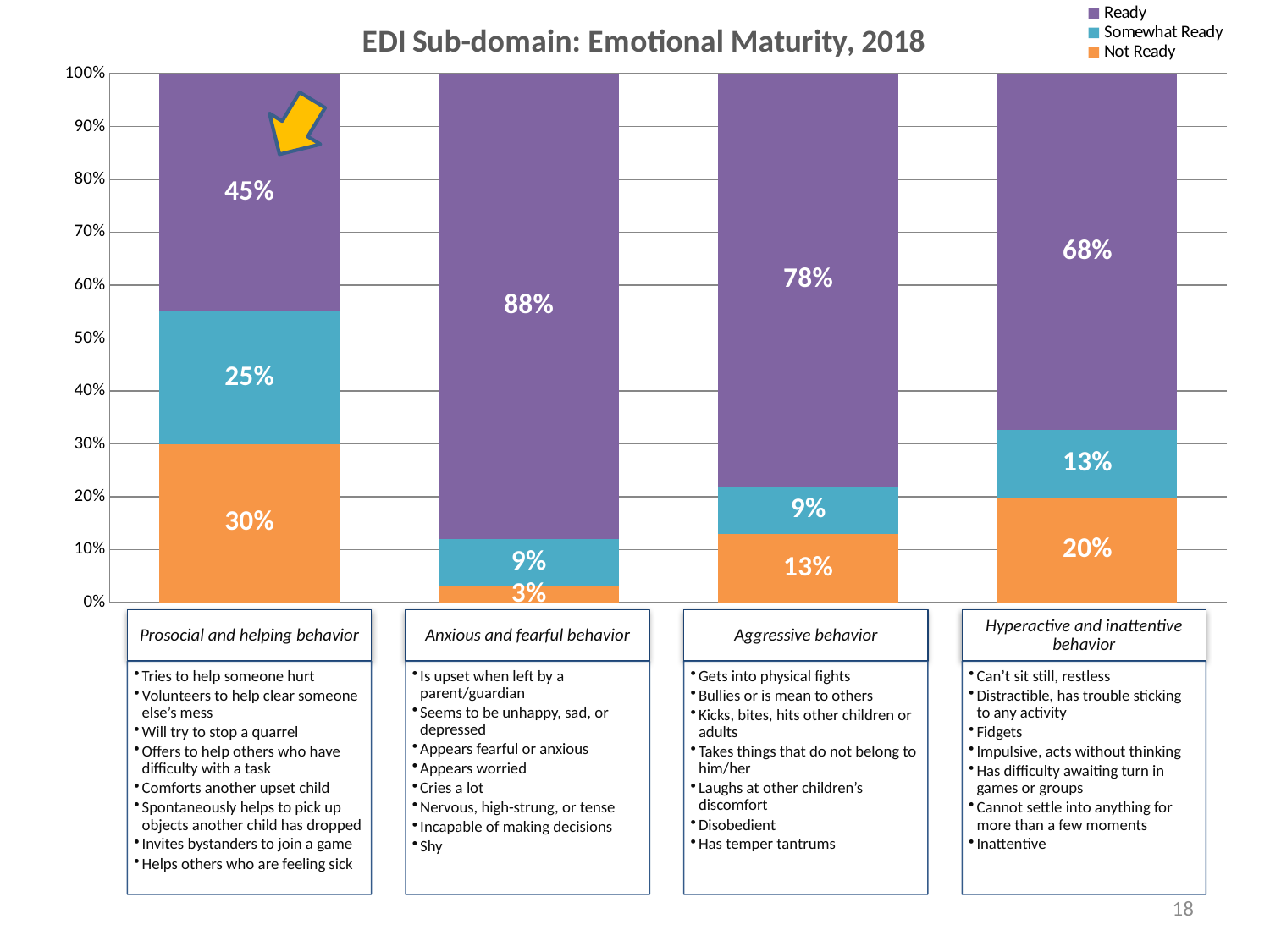
Which is larger: the Not Ready value for Prosocial and helping behavior or the Not Ready value for Aggressive behavior? Prosocial and helping behavior How many categories (bars) are shown in the chart? 4 What is the difference between the Ready values for Aggressive behavior and Hyperactive and inattentive behavior? 10% How many series does the legend list? 3 Which category has the highest Ready value? Anxious and fearful behavior What is the Somewhat Ready value for Aggressive behavior? 9% What is the Ready value for Prosocial and helping behavior? 45% What is the Not Ready value for Anxious and fearful behavior? 3% What kind of chart is shown on the slide? stacked bar chart What is the Not Ready value for Hyperactive and inattentive behavior? 20% Which category has the lowest Ready value? Prosocial and helping behavior What is the chart's title? EDI Sub-domain: Emotional Maturity, 2018